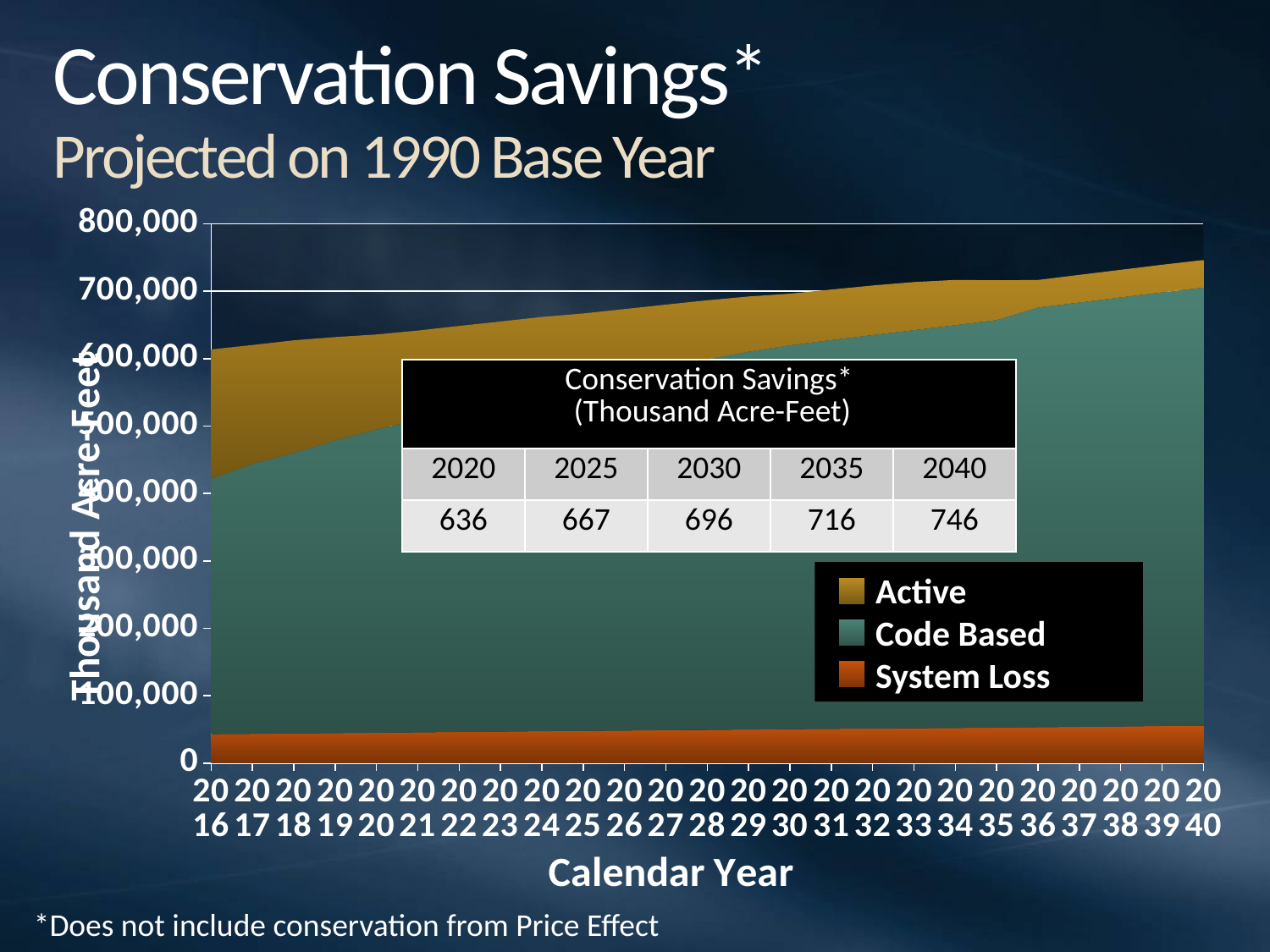
Do the total conservation savings rise or fall from 2016 to 2040? Rise Which series are listed in the legend? Active, Code Based, System Loss What is the title of the x axis? Calendar Year What kind of chart is shown on the slide? Stacked area chart According to the table, what is the Conservation Savings value for 2020? 636 Is the total stacked value for 2016 greater or less than 700,000? less Which year in the table has the highest Conservation Savings value? 2040 How many calendar years are shown along the x axis? 25 Which year in the table has the lowest Conservation Savings value? 2020 According to the table, what is the Conservation Savings value for 2035? 716 How many series does the legend list? 3 What is the difference between the Conservation Savings values for 2040 and 2020 in the table? 110